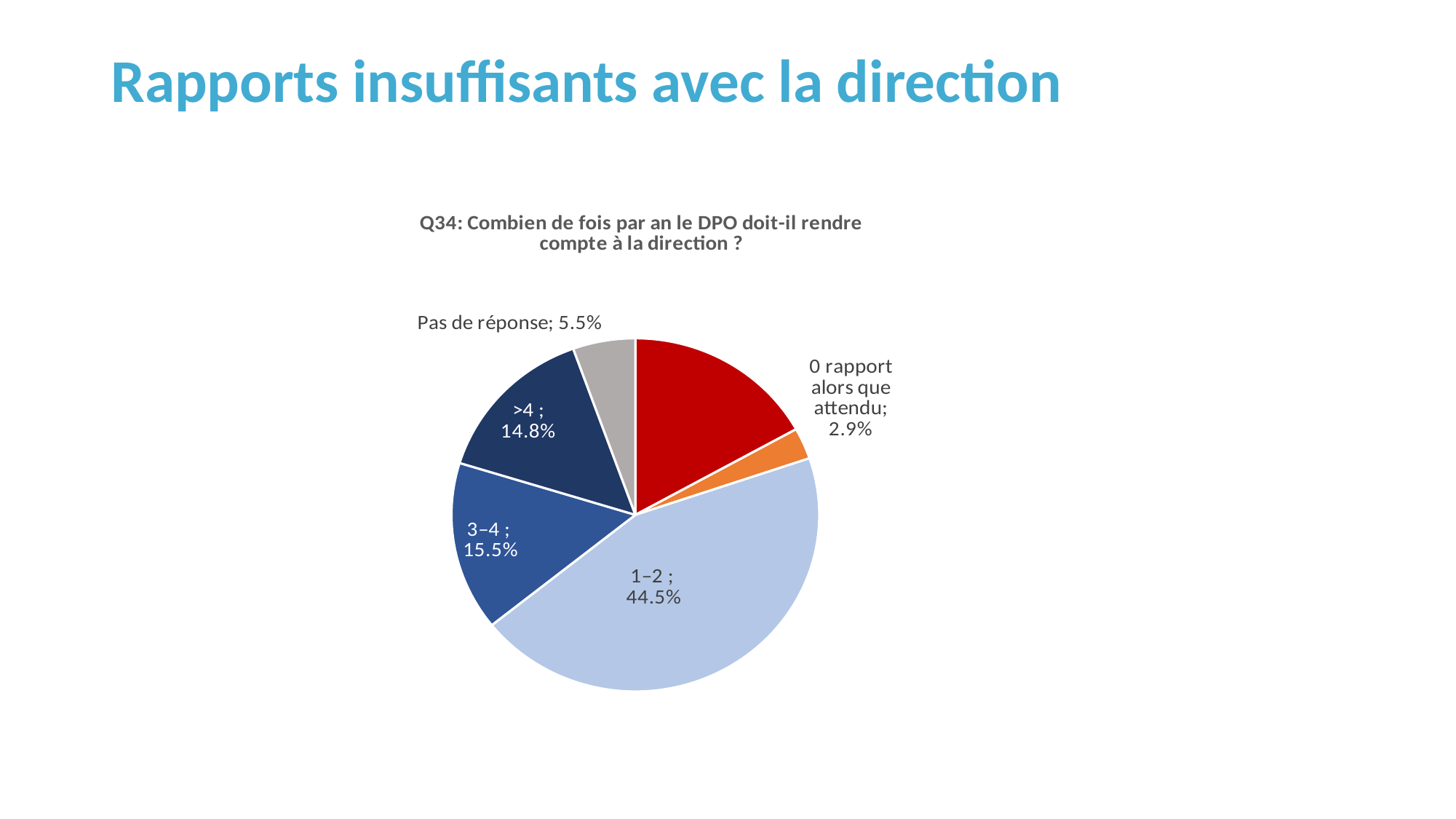
What percentage is shown for "0 rapport alors que attendu"? 2.9% What percentage is shown for the ">4" slice? 14.8% What percentage is shown for the "3–4" slice? 15.5% What kind of chart is shown on the slide? Pie chart Which labelled category has the largest share of the pie? 1–2 What is the title of the chart? Q34: Combien de fois par an le DPO doit-il rendre compte à la direction ? What share of responses is shown for the "1–2" slice? 44.5% Which slice is larger, "3–4" or ">4"? 3–4 How many slices does the pie chart have? 6 What is the difference in percentage points between the "1–2" slice and the "3–4" slice? 29.0% Which labelled category has the smallest share of the pie? 0 rapport alors que attendu What percentage is shown for "Pas de réponse"? 5.5%